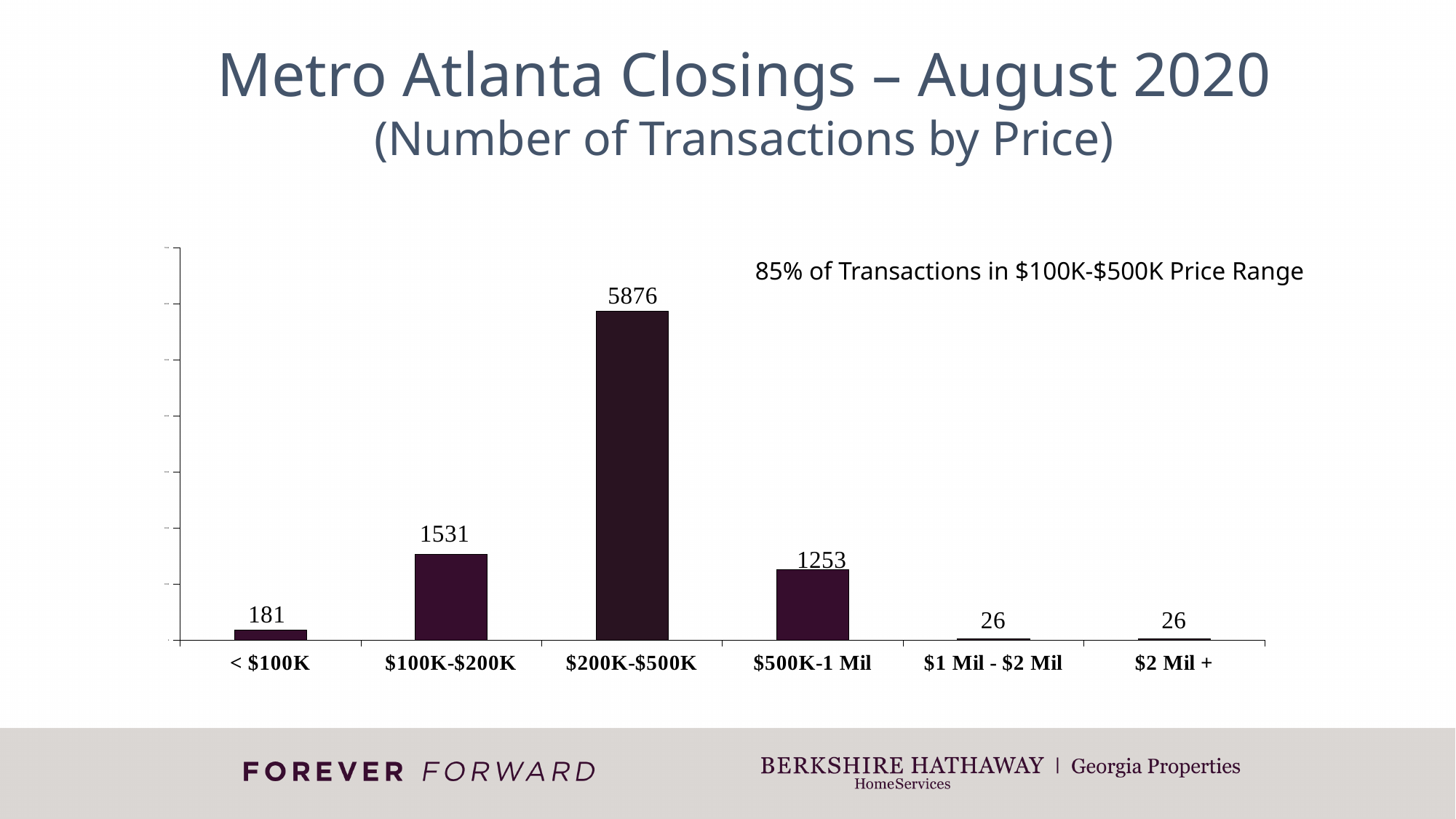
What is the difference between the $200K-$500K and $100K-$200K transaction counts? 4345 What is the number of transactions for the < $100K category? 181 According to the annotation on the chart, what percentage of transactions fall in the $100K-$500K price range? 85% How many transactions are shown for the $500K-1 Mil price range? 1253 What value is shown for the $1 Mil - $2 Mil category? 26 What type of chart is used on this slide? Bar chart What is the difference in transactions between the $100K-$200K and $500K-1 Mil price ranges? 278 How many price range categories are shown on the chart? 6 Which price range has the highest number of transactions? $200K-$500K How many transactions were closed in the $200K-$500K price range? 5876 Which has more transactions, < $100K or $2 Mil +? < $100K Which has more transactions, $100K-$200K or $500K-1 Mil? $100K-$200K